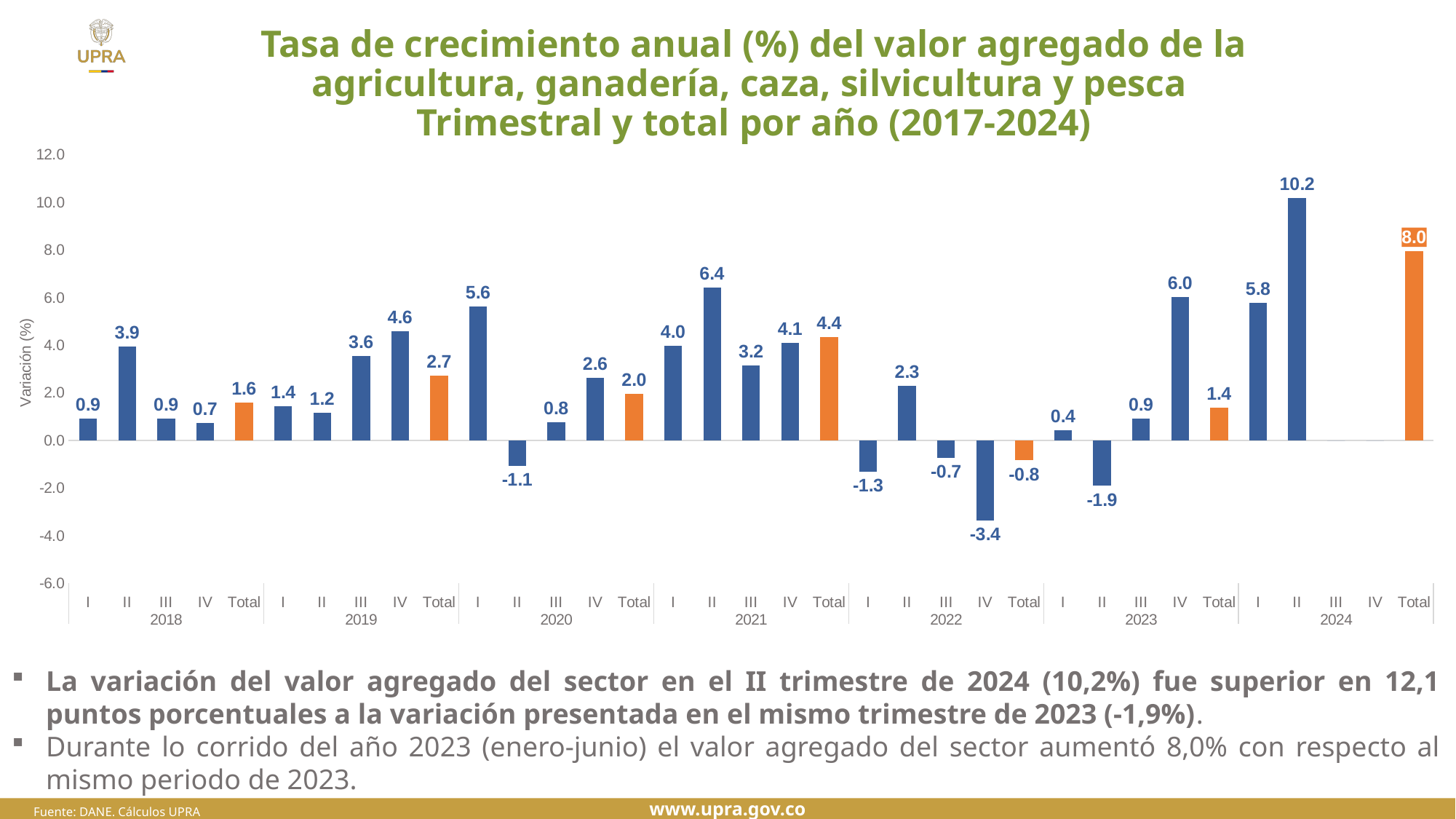
What colour are the annual Total bars on the chart? Orange Which is larger, the annual Total for 2019 or the annual Total for 2020? Total 2019 What is the annual Total value for 2024? 8.0 What is the value for quarter II of 2024? 10.2 Which quarter-year bar has the highest value on the chart? II 2024 Which quarter-year bar has the lowest value on the chart? IV 2022 What is the value for quarter IV of 2022? -3.4 Do the values rise or fall across the four quarters of 2021 from quarter II to quarter III? Fall What is the difference between the annual Total for 2021 and the annual Total for 2022? 5.2 What is the difference between the value for quarter II of 2024 and quarter II of 2023? 12.1 What is the annual Total value for 2021? 4.4 What type of chart is shown on the slide? Bar chart